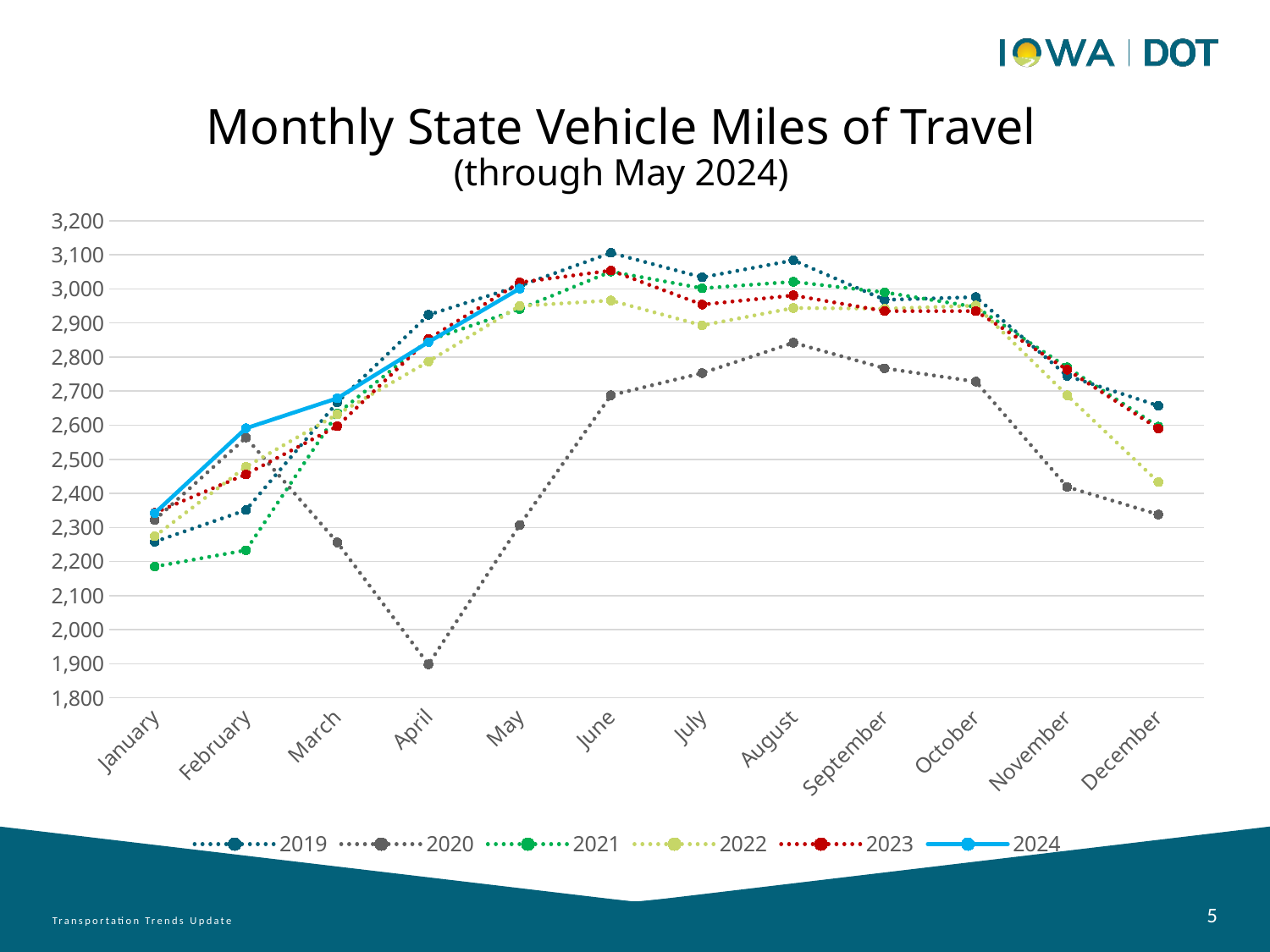
How many months are shown along the x axis? 12 Which year has the lowest value in April? 2020 Does the 2020 line rise or fall from February to April? Fall Which year has the highest value in June? 2019 Is the 2020 value for April greater or less than 2,000? less In January, which is larger: the 2024 value or the 2021 value? 2024 Is the 2020 value for December greater or less than 2,400? less Does the 2024 line rise or fall from January to May? Rise Which series is drawn as a solid line rather than a dotted line? 2024 What kind of chart is shown on the slide? Line chart Is the 2019 value for June greater or less than 3,000? greater How many series does the legend list? 6